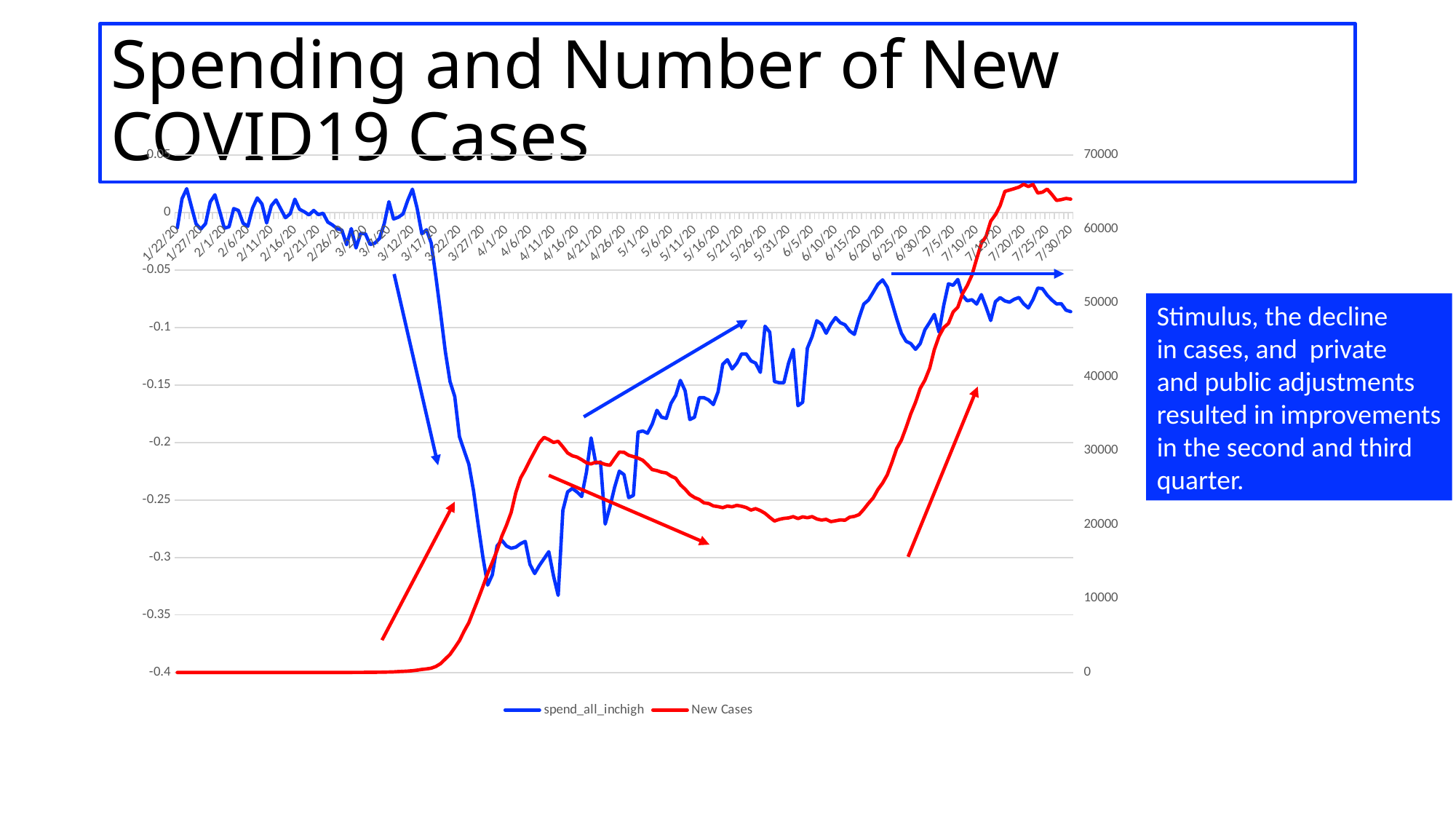
Is the value of New Cases at 7/20/20 greater or less than 60000? greater Does the New Cases line rise or fall between 4/11/20 and 5/31/20? fall What kind of chart is shown on the slide? line chart Is the value of New Cases at 5/31/20 greater or less than 30000? less Is the value of spend_all_inchigh at 4/1/20 greater or less than -0.2? less What are the two series named in the legend? spend_all_inchigh and New Cases Which colour is used for the New Cases series? red Does the New Cases line rise or fall between 6/15/20 and 7/15/20? rise How many series does the legend list? 2 Does the spend_all_inchigh line rise or fall between 3/12/20 and 4/1/20? fall